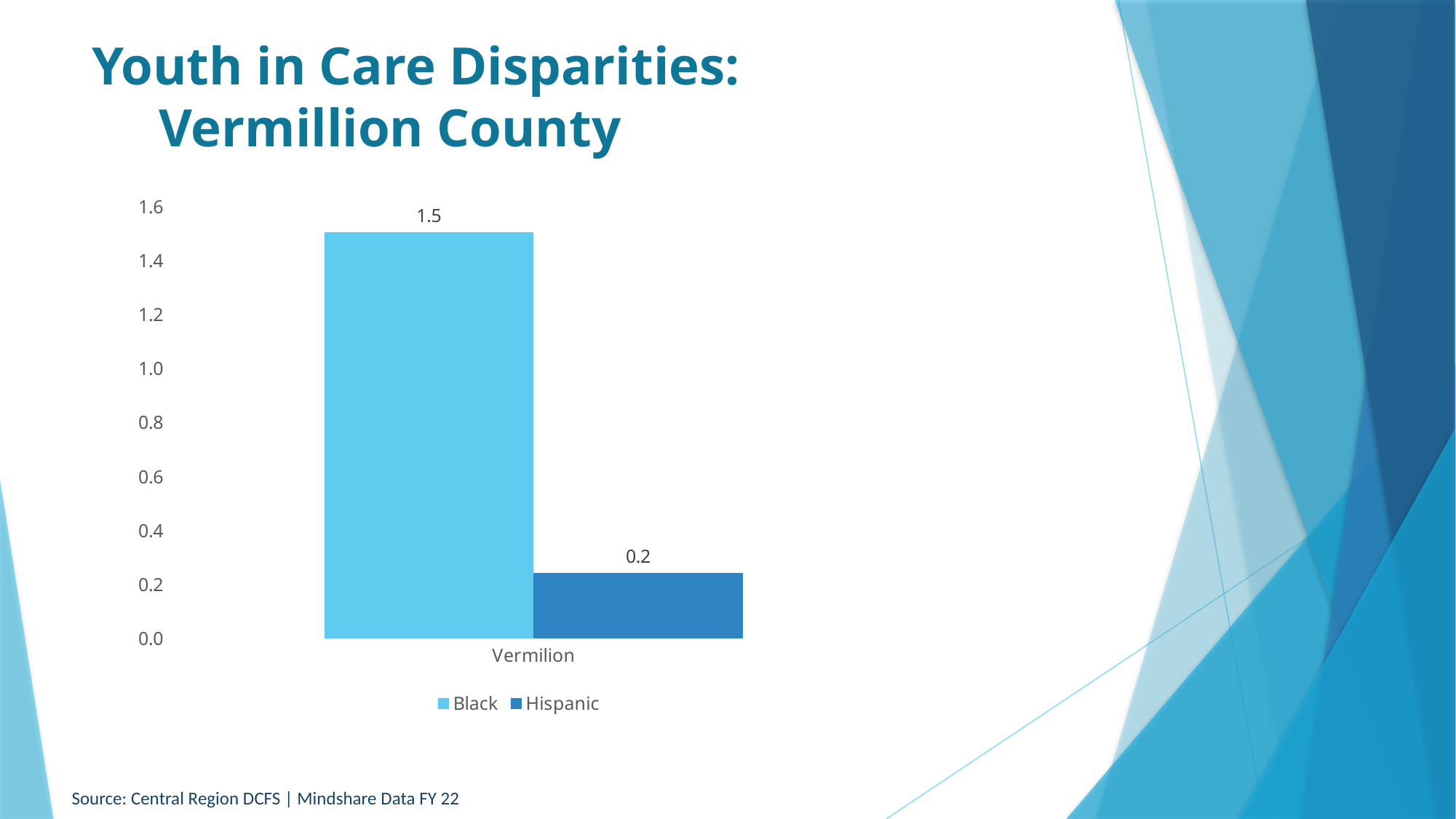
What is the difference between the Black and Hispanic values for Vermilion? 1.3 What is the category label on the x axis? Vermilion How many categories are shown on the x axis? 1 Which series has the higher value for Vermilion, Black or Hispanic? Black Is the value for Black in Vermilion greater or less than 1.0? greater What is the highest value shown on the y axis? 1.6 What is the value for Hispanic in Vermilion? 0.2 Which series has the lowest value in the chart? Hispanic What is the value for Black in Vermilion? 1.5 How many series does the legend list? 2 What kind of chart is shown on the slide? Bar chart Is the value for Hispanic in Vermilion greater or less than 0.4? less